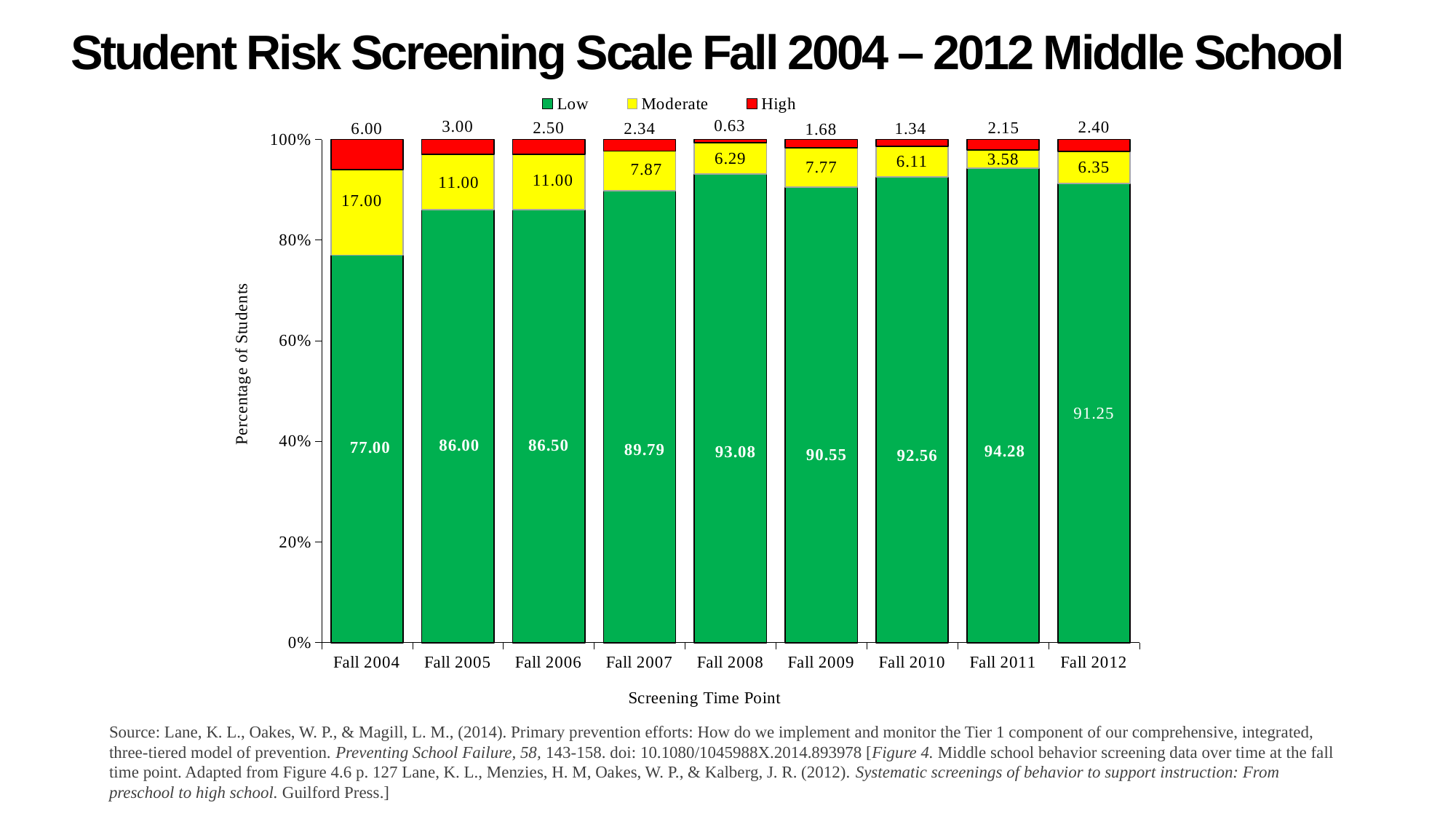
How many screening time points are shown on the x axis? 9 What is the High value for Fall 2008? 0.63 What is the Moderate value for Fall 2007? 7.87 Which time point has the lowest High value? Fall 2008 What kind of chart is shown on the slide? Stacked bar chart How many series does the legend list? 3 What is the label of the y axis? Percentage of Students What is the Low value for Fall 2004? 77.00 Which is larger, the High value for Fall 2004 or the High value for Fall 2012? Fall 2004 What is the Low value for Fall 2012? 91.25 Which time point has the highest Low value? Fall 2011 What is the difference between the Moderate values for Fall 2004 and Fall 2005? 6.00